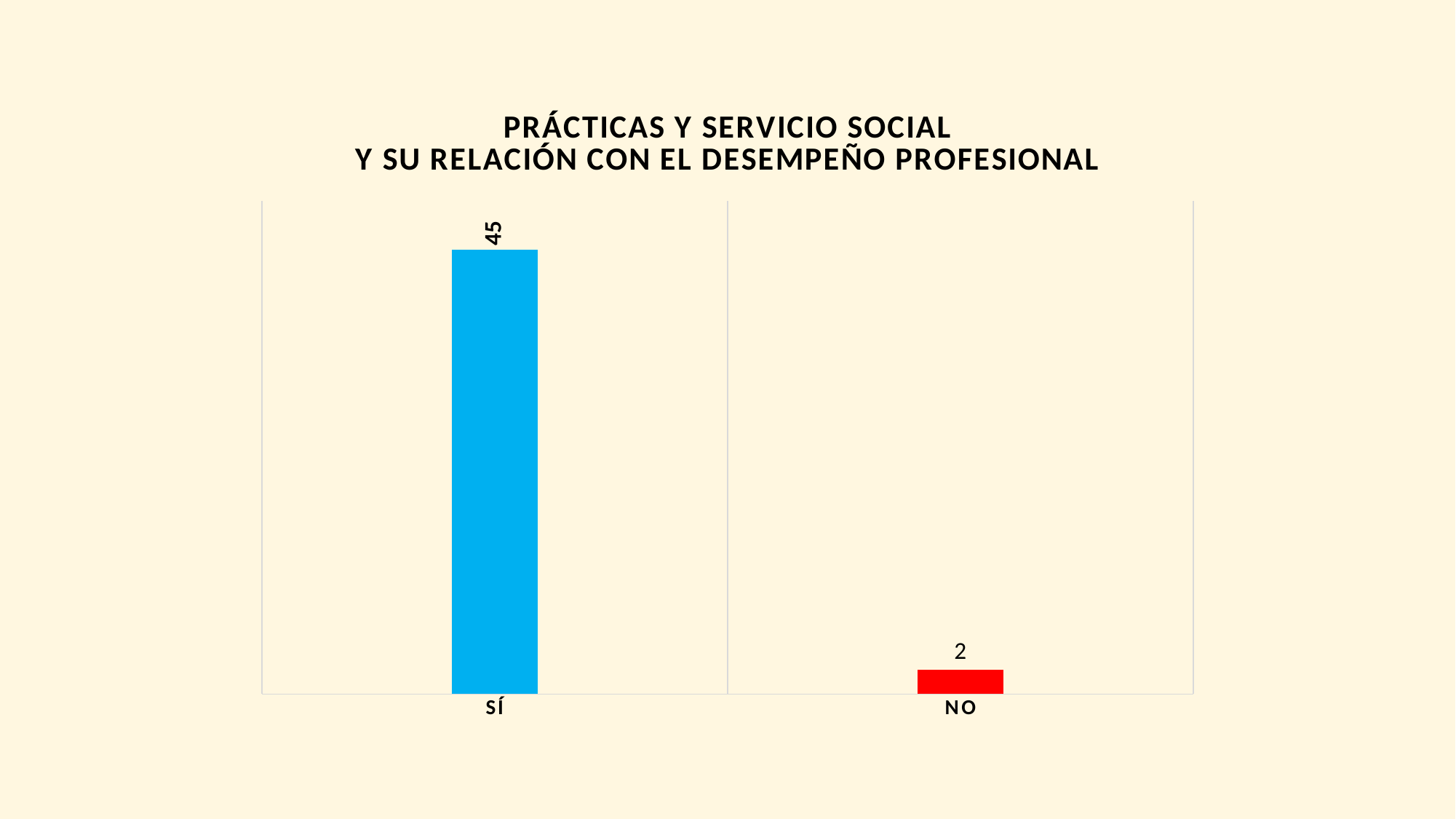
Which is larger, the value for SÍ or the value for NO? SÍ What is the difference between the values for SÍ and NO? 43 Which category has the highest value? SÍ What is the value for NO? 2 How many categories are shown in the chart? 2 What is the title of the chart? PRÁCTICAS Y SERVICIO SOCIAL Y SU RELACIÓN CON EL DESEMPEÑO PROFESIONAL What is the total of the values for SÍ and NO? 47 Which category has the lowest value? NO What is the value for SÍ? 45 What colour is the bar for NO? Red What kind of chart is shown on the slide? Bar chart